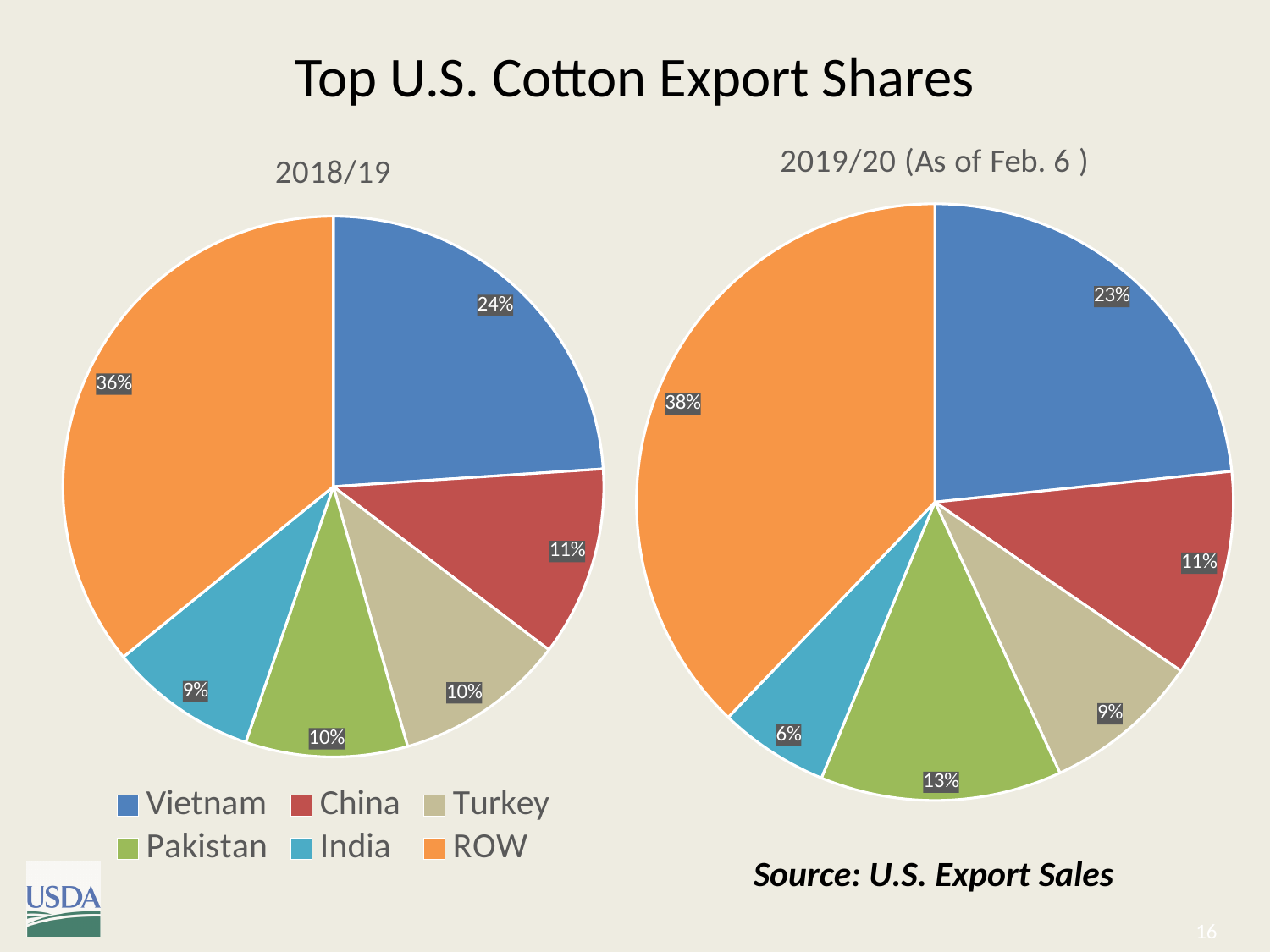
What is the title of the slide containing the two pie charts? Top U.S. Cotton Export Shares In the 2018/19 pie chart, which category has the largest share? ROW In the 2018/19 pie chart, what share does China have? 11% In the 2019/20 (As of Feb. 6) pie chart, what share does Pakistan have? 13% In the 2019/20 (As of Feb. 6) pie chart, which category has the smallest share? India In the 2018/19 pie chart, what share does Vietnam have? 24% How many slices does the 2018/19 pie chart have? 6 In the 2019/20 (As of Feb. 6) pie chart, which is larger, the share for Pakistan or the share for Turkey? Pakistan In the 2019/20 (As of Feb. 6) pie chart, what share does India have? 6% How many entries does the legend list? 6 What is the difference between the ROW share in the 2019/20 (As of Feb. 6) chart and the ROW share in the 2018/19 chart? 2% What type of chart is used for the 2018/19 data? Pie chart